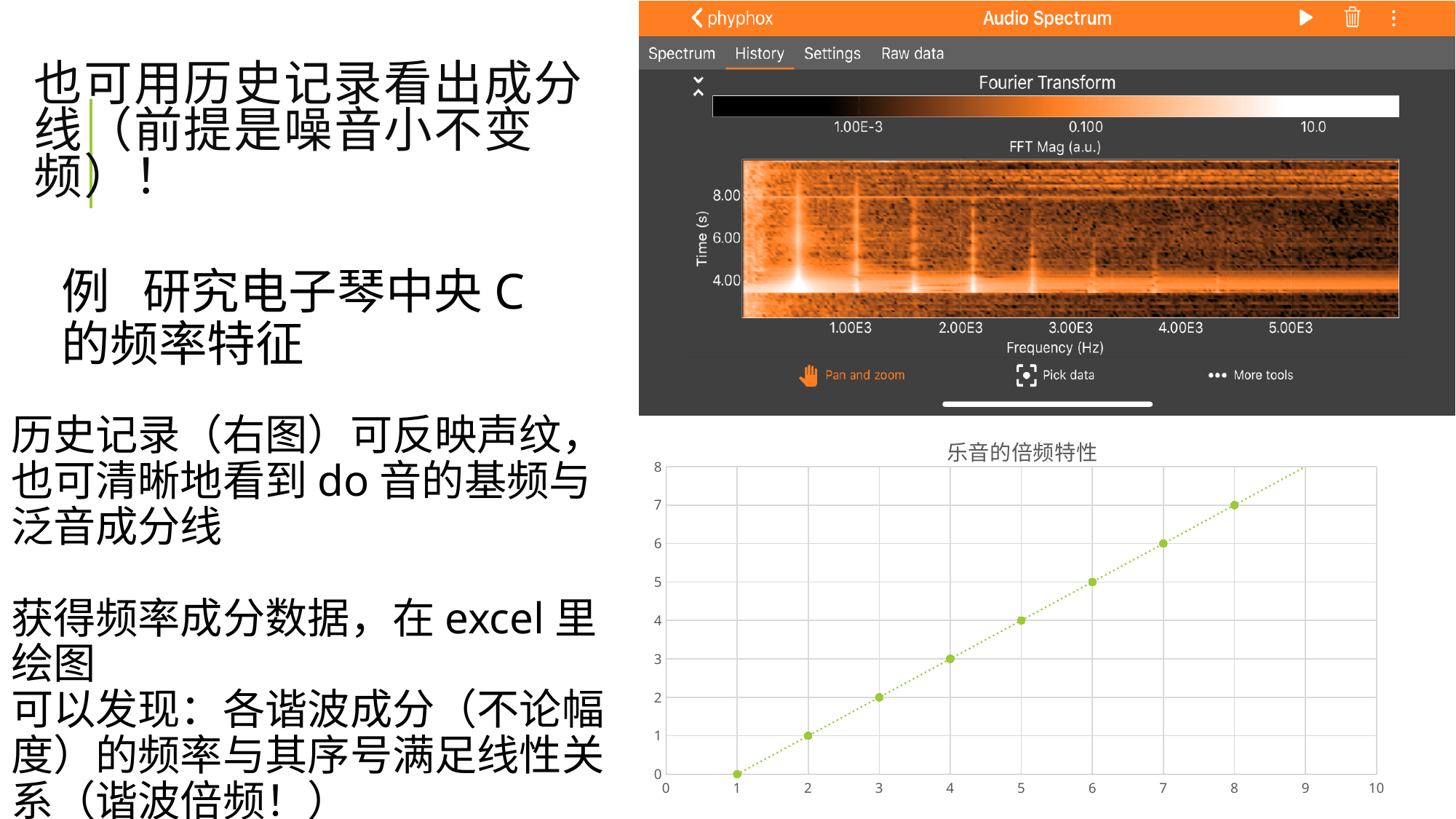
In the chart titled 乐音的倍频特性, do the y values rise or fall as x increases? rise In the chart titled 乐音的倍频特性, what is the y value of the point at x = 8? 7 In the chart titled 乐音的倍频特性, what is the y value of the point at x = 1? 0 In the chart titled 乐音的倍频特性, what is the maximum value shown on the x axis? 10 In the chart titled 乐音的倍频特性, how many data points are plotted? 8 In the chart titled 乐音的倍频特性, what is the difference between the y values at x = 7 and x = 3? 4 In the chart titled 乐音的倍频特性, which has the larger y value: the point at x = 4 or the point at x = 6? x = 6 In the spectrogram chart at the top right of the slide, what is the label of the horizontal axis? Frequency (Hz) In the chart titled 乐音的倍频特性, at which x value is the plotted y value highest? 8 In the chart titled 乐音的倍频特性, is the y value at x = 7 greater or less than 5? greater In the chart titled 乐音的倍频特性, at which x value is the plotted y value lowest? 1 In the chart titled 乐音的倍频特性, what is the y value of the point at x = 5? 4